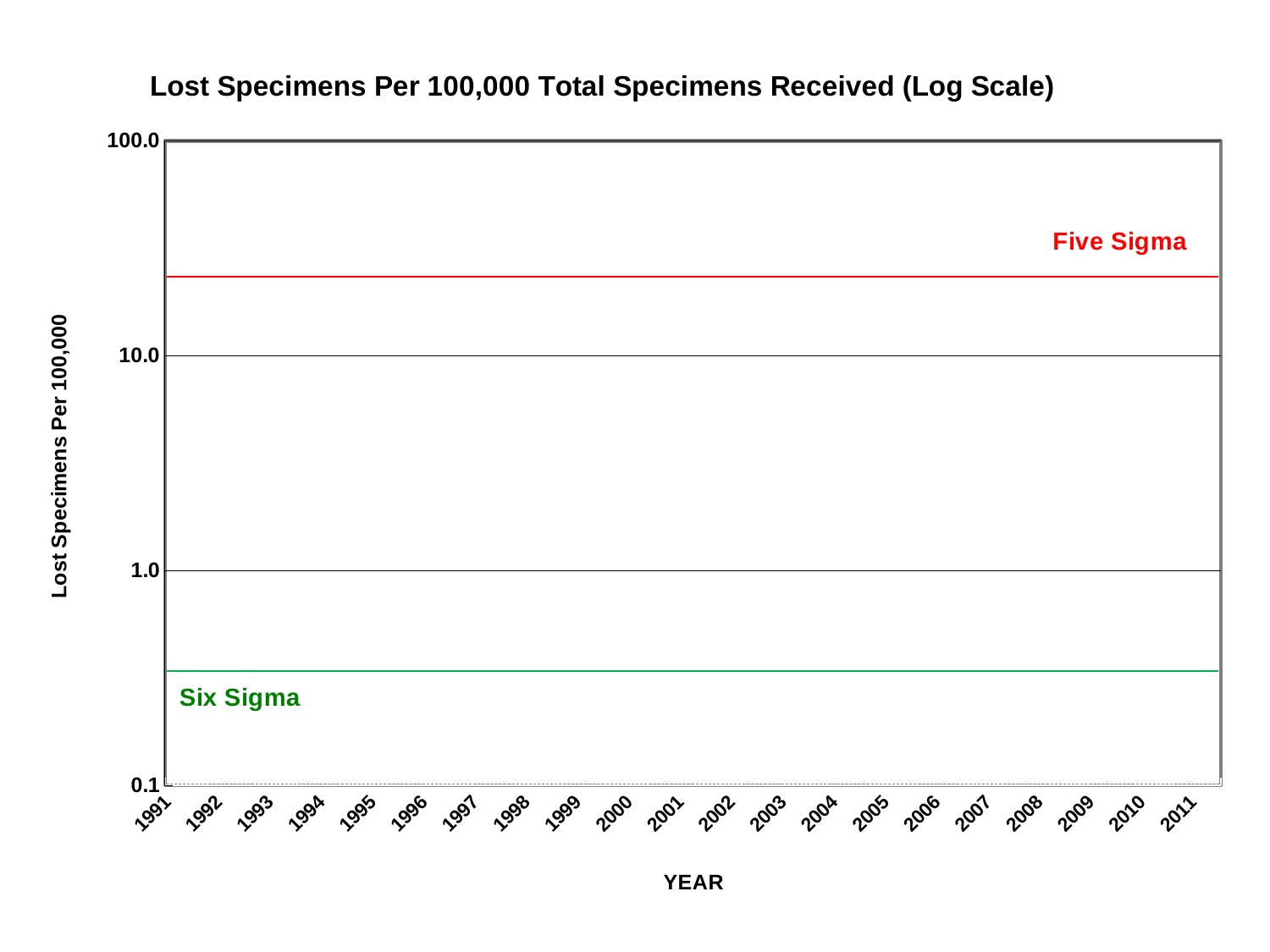
Is the Five Sigma line greater or less than 100.0? less Does the Five Sigma line rise, fall, or stay flat from 1991 to 2011? stays flat What colour is the Six Sigma line? green How many years are labelled along the x axis? 21 Which line is higher on the chart, Five Sigma or Six Sigma? Five Sigma What kind of chart is shown on the slide? line chart Is the Six Sigma line greater or less than 1.0? less What is the last year shown on the x axis? 2011 What is the first year shown on the x axis? 1991 Is the Six Sigma line greater or less than 0.1? greater What is the title of the chart? Lost Specimens Per 100,000 Total Specimens Received (Log Scale)